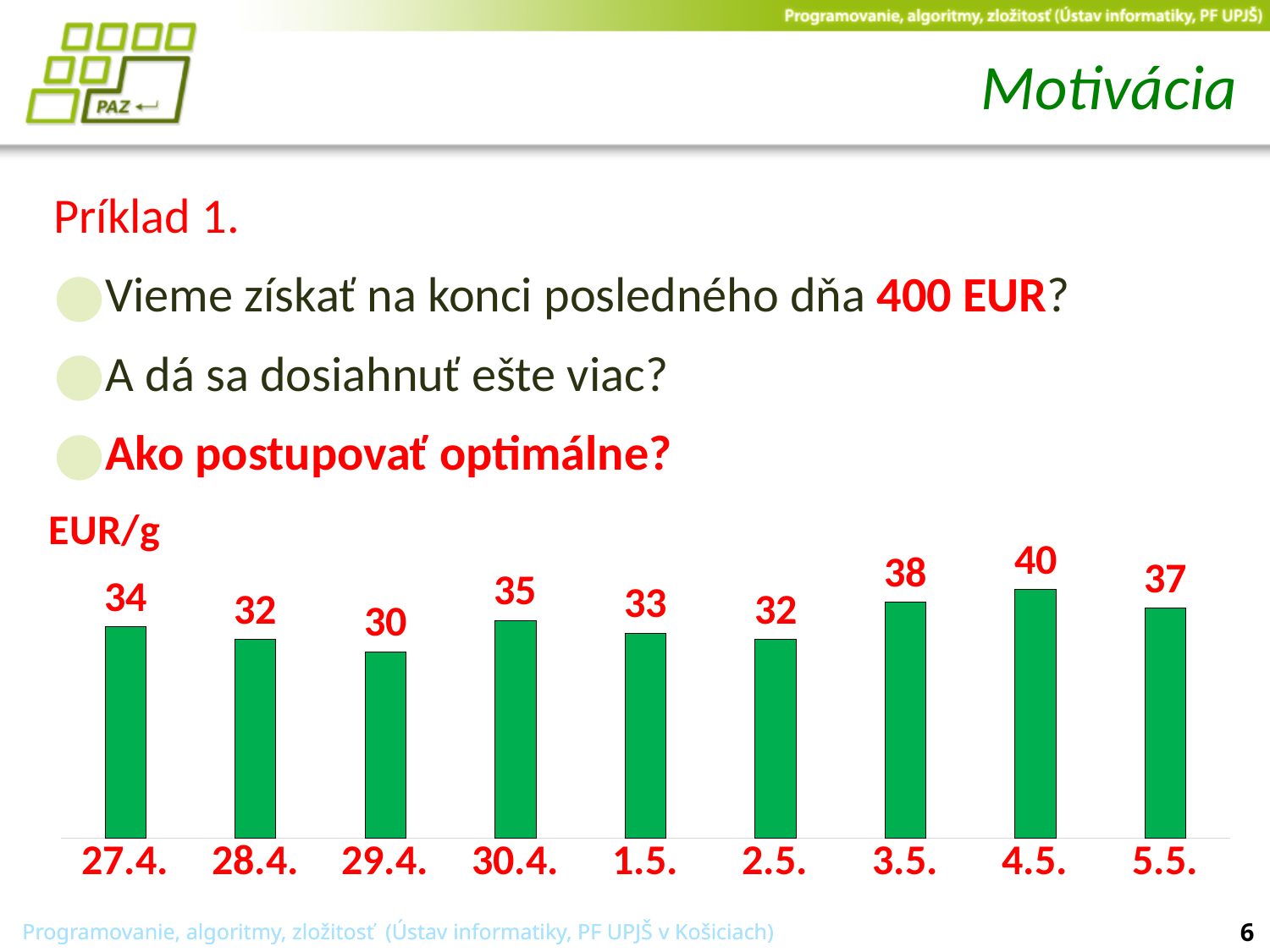
What is the difference between the values for 4.5. and 29.4.? 10 Which date has the lowest value? 29.4. Do the values rise or fall from 2.5. to 4.5.? rise Which is larger, the value for 30.4. or the value for 1.5.? 30.4. What is the value for 27.4.? 34 What is the value for 3.5.? 38 Which date has the highest value? 4.5. What is the value for 29.4.? 30 How many dates are shown on the x axis? 9 What kind of chart is shown on the slide? bar chart What is the difference between the values for 5.5. and 2.5.? 5 What unit label is shown above the chart? EUR/g